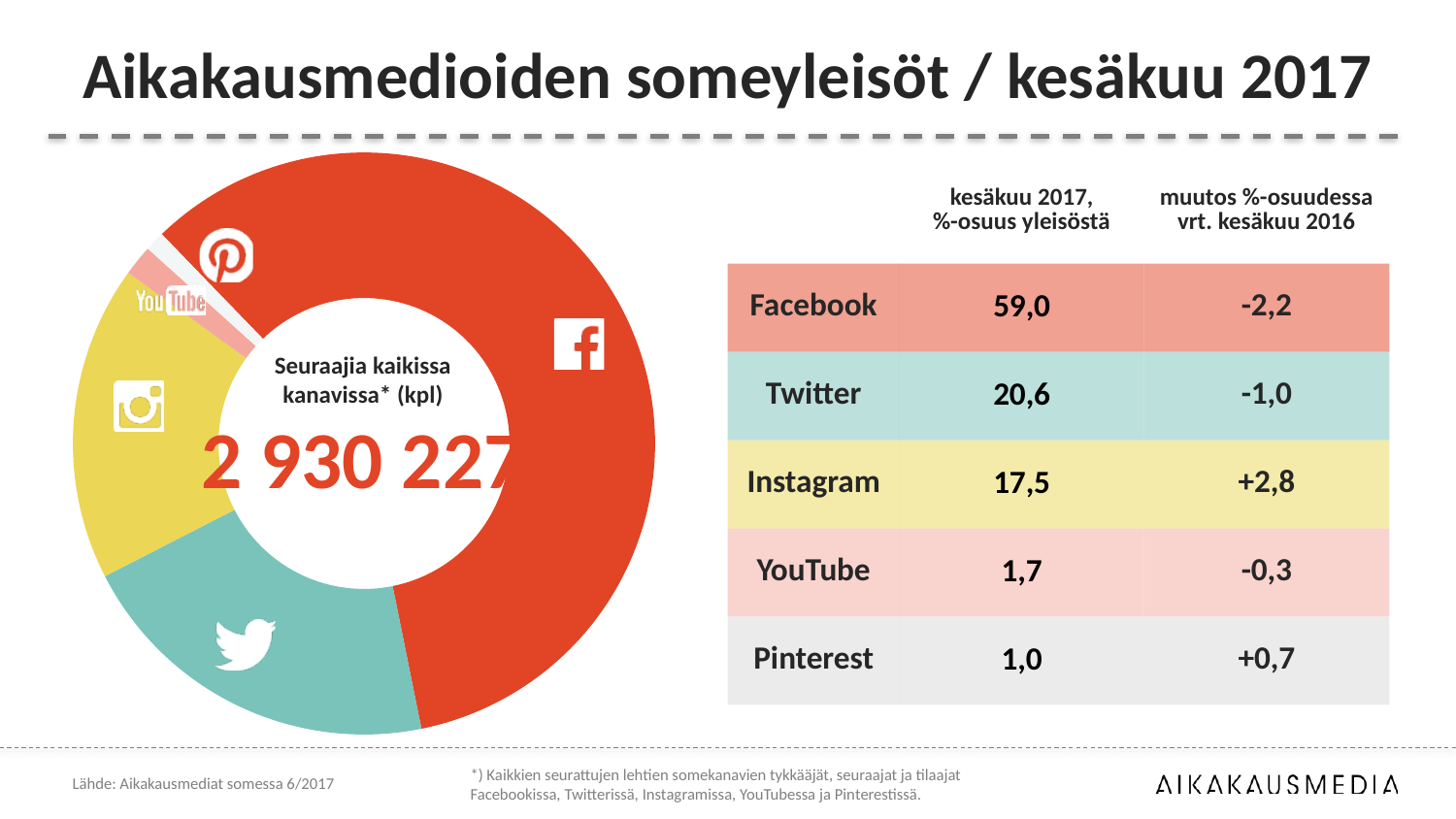
What is the difference in percentage share between Facebook (59,0) and Twitter (20,6)? 38,4 Which channel has the smallest slice in the donut chart? Pinterest What total number of followers across all channels is printed in the centre of the donut chart? 2 930 227 What share of the audience does Facebook hold in June 2017, according to the slide? 59,0 What kind of chart is shown on the left of the slide? Donut (pie) chart What share of the audience does Instagram hold in June 2017? 17,5 Which slice is larger in the donut chart, Twitter or Instagram? Twitter Which channel has the largest slice in the donut chart? Facebook What share of the audience does YouTube hold in June 2017? 1,7 What is the change in Instagram's percentage share compared with June 2016? +2,8 How many social media channels are shown as slices in the donut chart? 5 What colour is the Twitter slice in the donut chart? Teal (light blue-green)